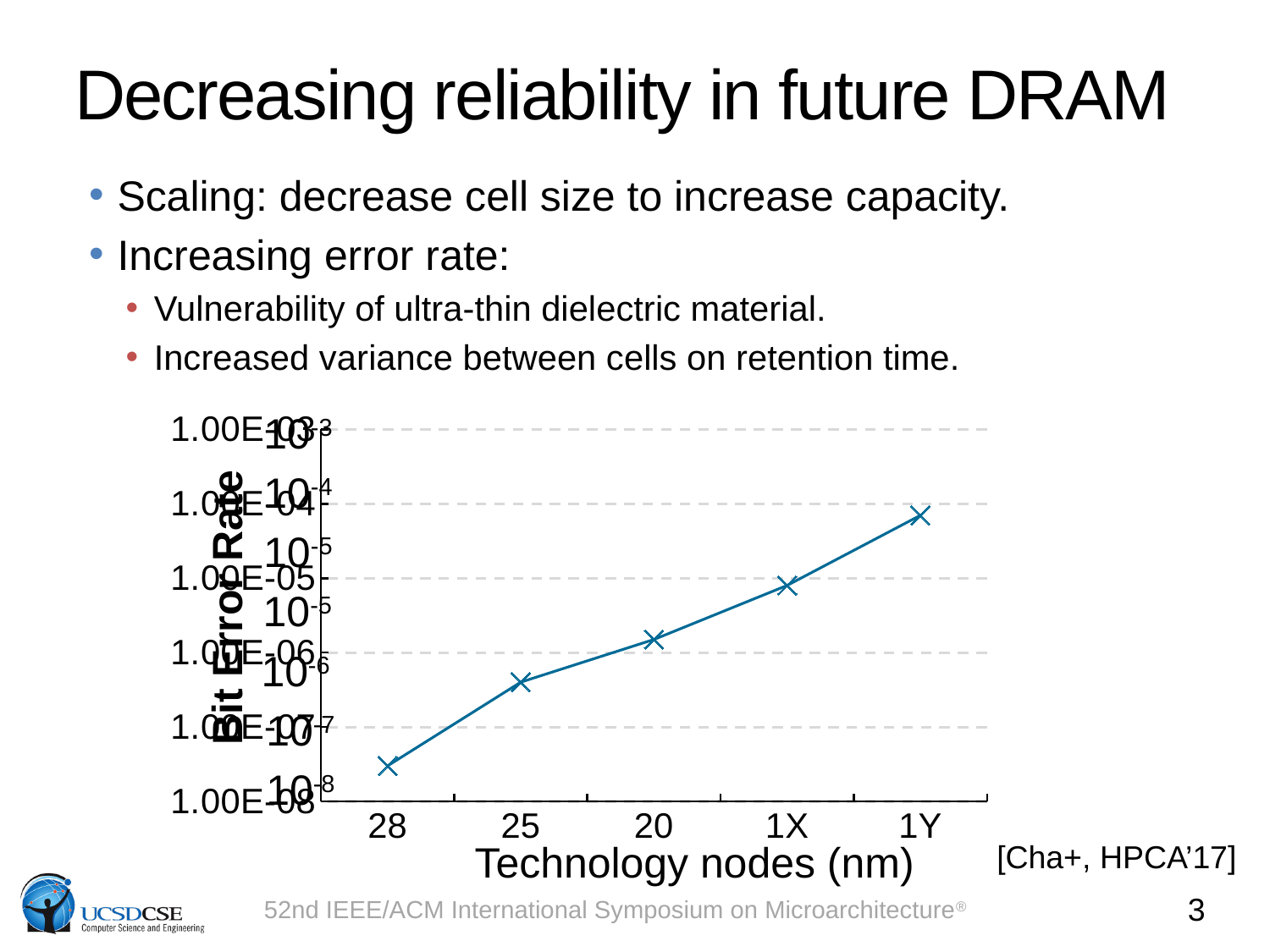
Does the bit error rate rise or fall as the technology nodes go from 28 to 1Y along the x axis? rise What is the title of the y axis of the chart? Bit Error Rate Is the bit error rate for the 1X node greater or less than 1.00E-04? less Which has a higher bit error rate, the 25 nm node or the 20 nm node? 20 Is the bit error rate for the 28 nm node greater or less than 1.00E-07? less What is the title of the x axis of the chart? Technology nodes (nm) Is the bit error rate for the 25 nm node greater or less than 1.00E-06? less Which technology node has the lowest bit error rate? 28 Which technology node has the highest bit error rate? 1Y What kind of chart is shown on the slide? line chart How many technology nodes are plotted on the x axis? 5